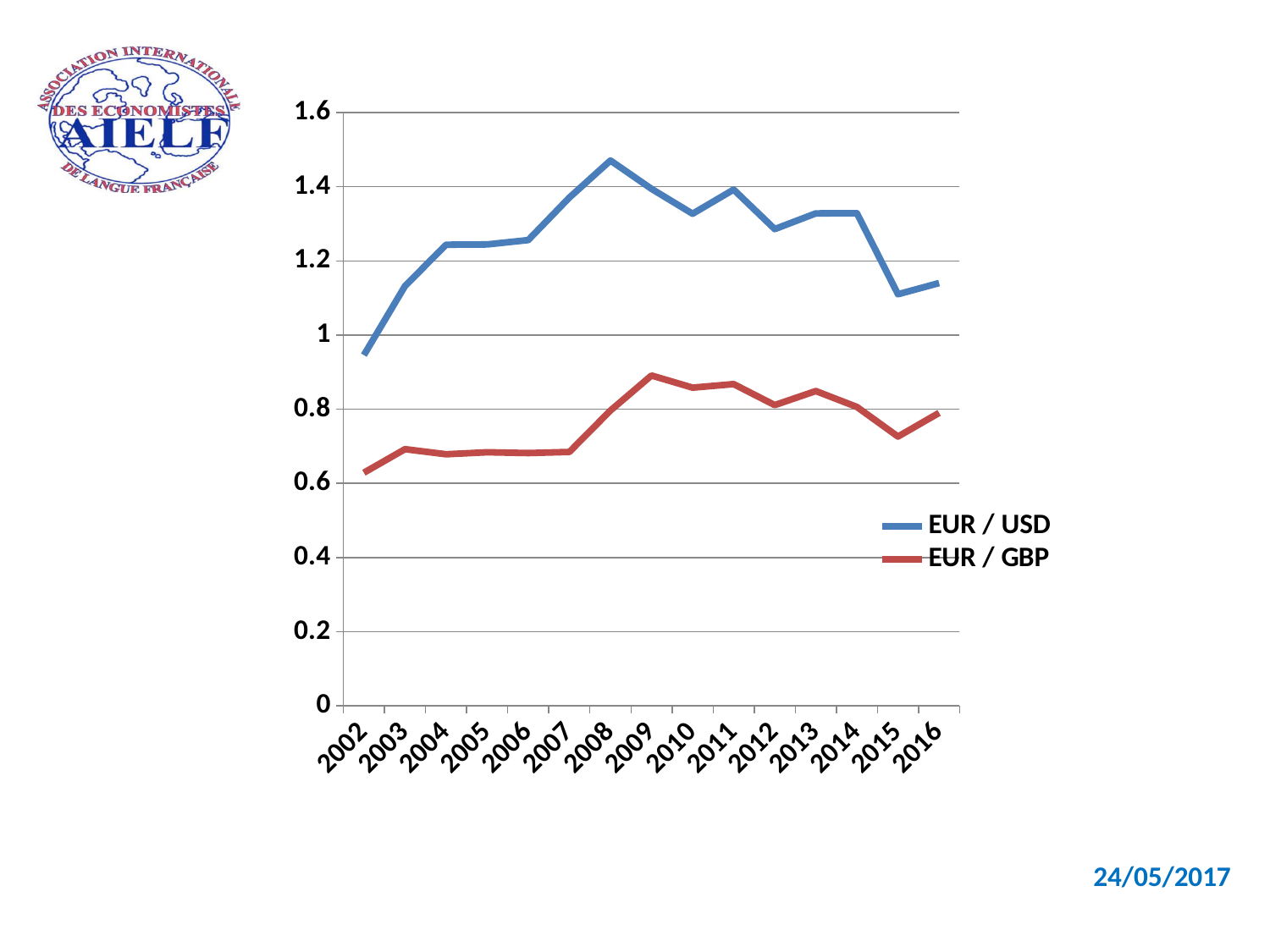
In which year is the EUR / GBP series at its lowest value? 2002 How many series does the legend list? 2 Which series has the higher value in 2010, EUR / USD or EUR / GBP? EUR / USD In which year is the EUR / USD series at its lowest value? 2002 What colour is the EUR / GBP line? Red Is the EUR / USD value for 2002 greater or less than 1? less How many years are plotted along the x axis? 15 Is the EUR / USD value for 2008 greater or less than 1.4? greater In which year does the EUR / USD series reach its highest value? 2008 Does the EUR / USD series rise or fall between 2002 and 2008? rise What kind of chart is shown on the slide? Line chart Is the EUR / GBP value for 2009 greater or less than 0.8? greater